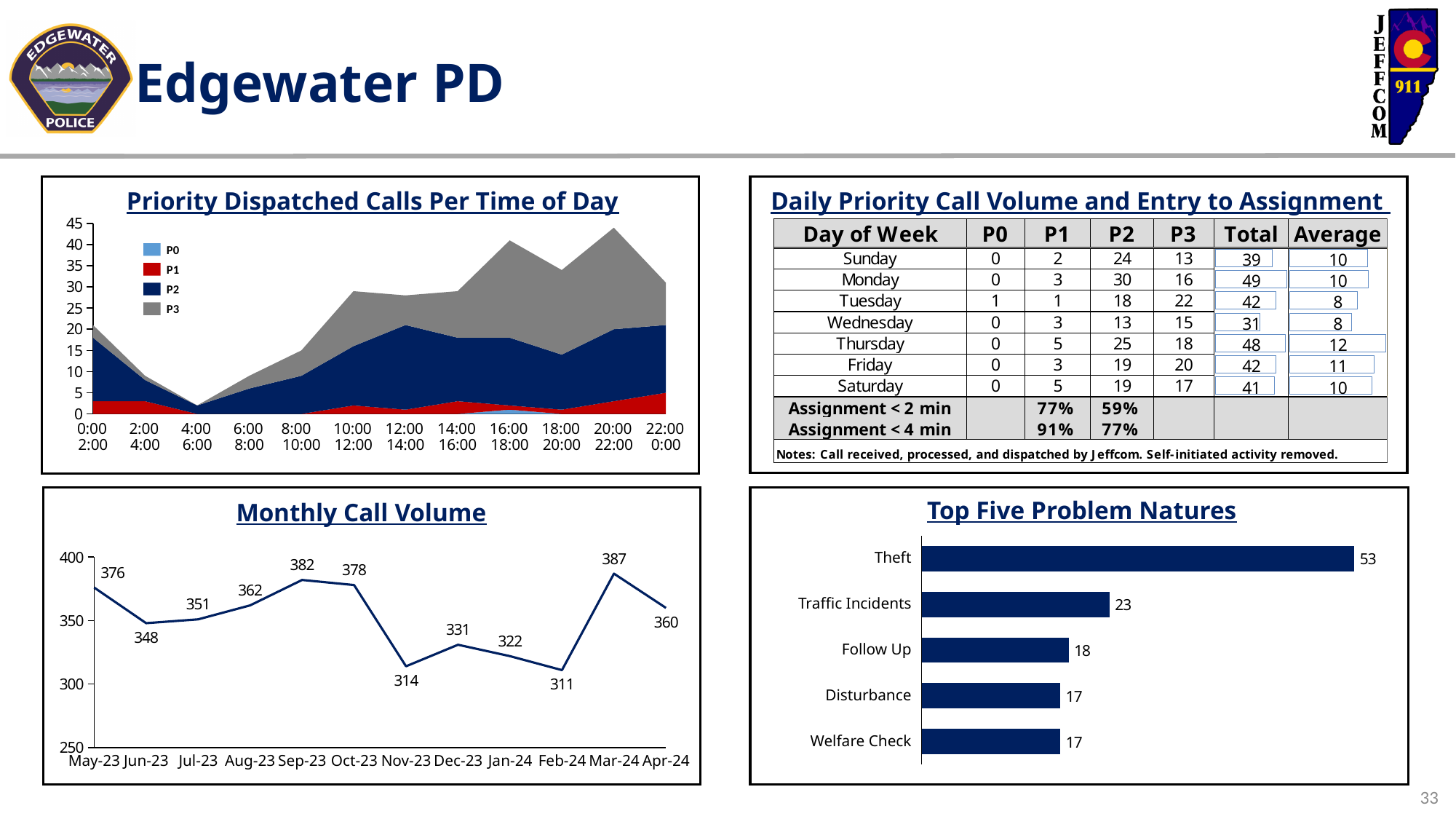
In the Monthly Call Volume chart, how many months are plotted? 12 In the Monthly Call Volume chart, what is the difference between the values for Mar-24 and Apr-24? 27 What kind of chart is the Top Five Problem Natures chart? Bar chart In the Monthly Call Volume chart, which is larger, the value for Oct-23 or the value for Nov-23? Oct-23 In the Monthly Call Volume chart, what is the value for Sep-23? 382 In the Monthly Call Volume chart, which month has the lowest call volume? Feb-24 In the Priority Dispatched Calls Per Time of Day chart, is the total stacked value for 20:00-22:00 greater or less than 40? greater In the Top Five Problem Natures chart, what is the difference between Theft and Follow Up? 35 In the Top Five Problem Natures chart, which problem nature has the highest value? Theft In the Priority Dispatched Calls Per Time of Day chart, how many series does the legend list? 4 In the Top Five Problem Natures chart, what is the value for Traffic Incidents? 23 In the Monthly Call Volume chart, which month has the highest call volume? Mar-24